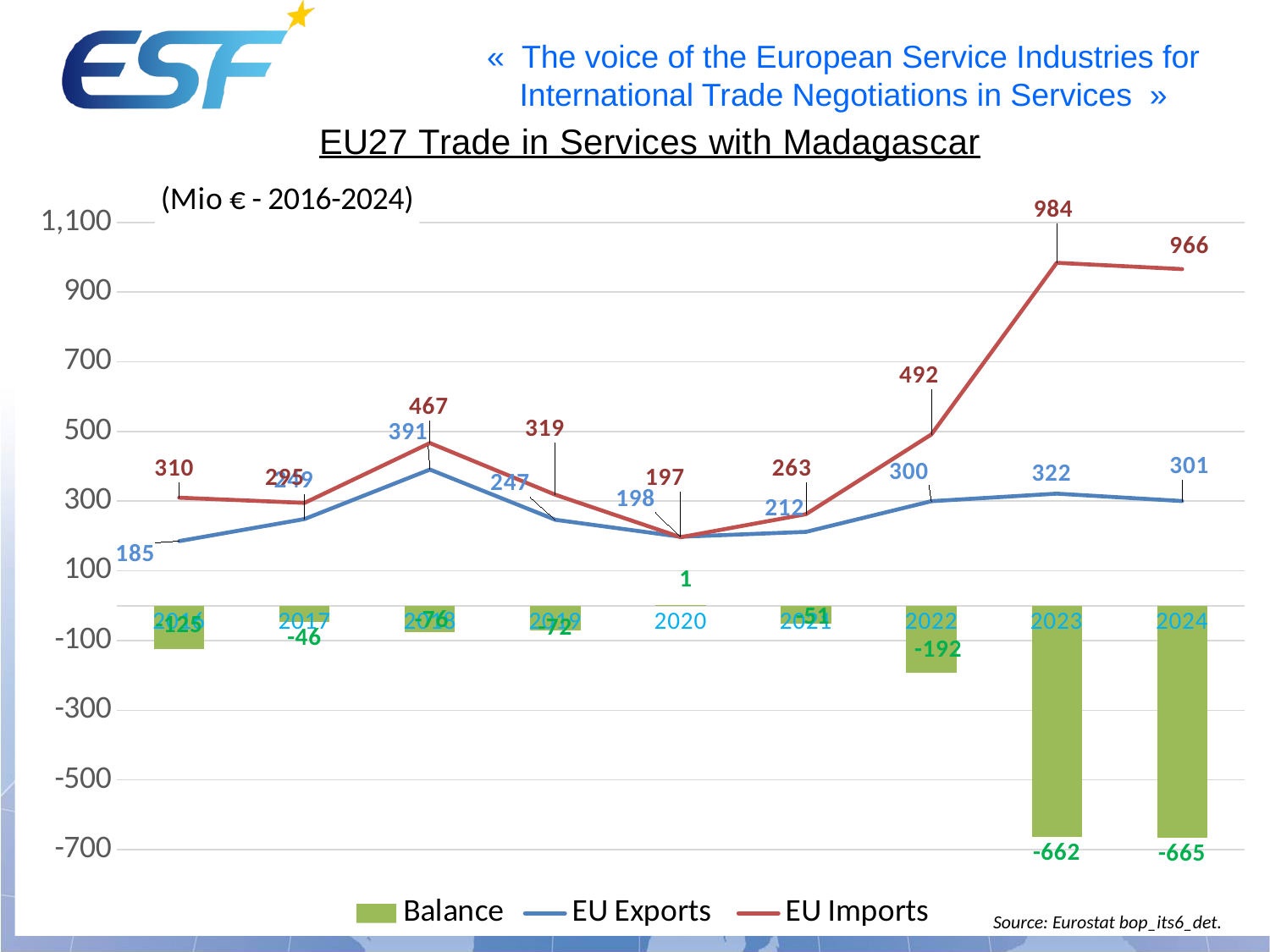
Do EU Imports rise or fall from 2021 to 2023? rise How many years are shown on the x axis? 9 Is the value for EU Exports in 2023 greater or less than 500? less What is the Balance value for 2024? -665 What is the value of EU Exports in 2016? 185 What is the value of EU Imports in 2023? 984 In which year is the Balance lowest? 2024 In which year are EU Imports highest? 2023 In 2022, which is larger: EU Imports or EU Exports? EU Imports How many series does the legend list? 3 What is the difference between EU Imports and EU Exports in 2024? 665 What is the Balance value for 2020? 1